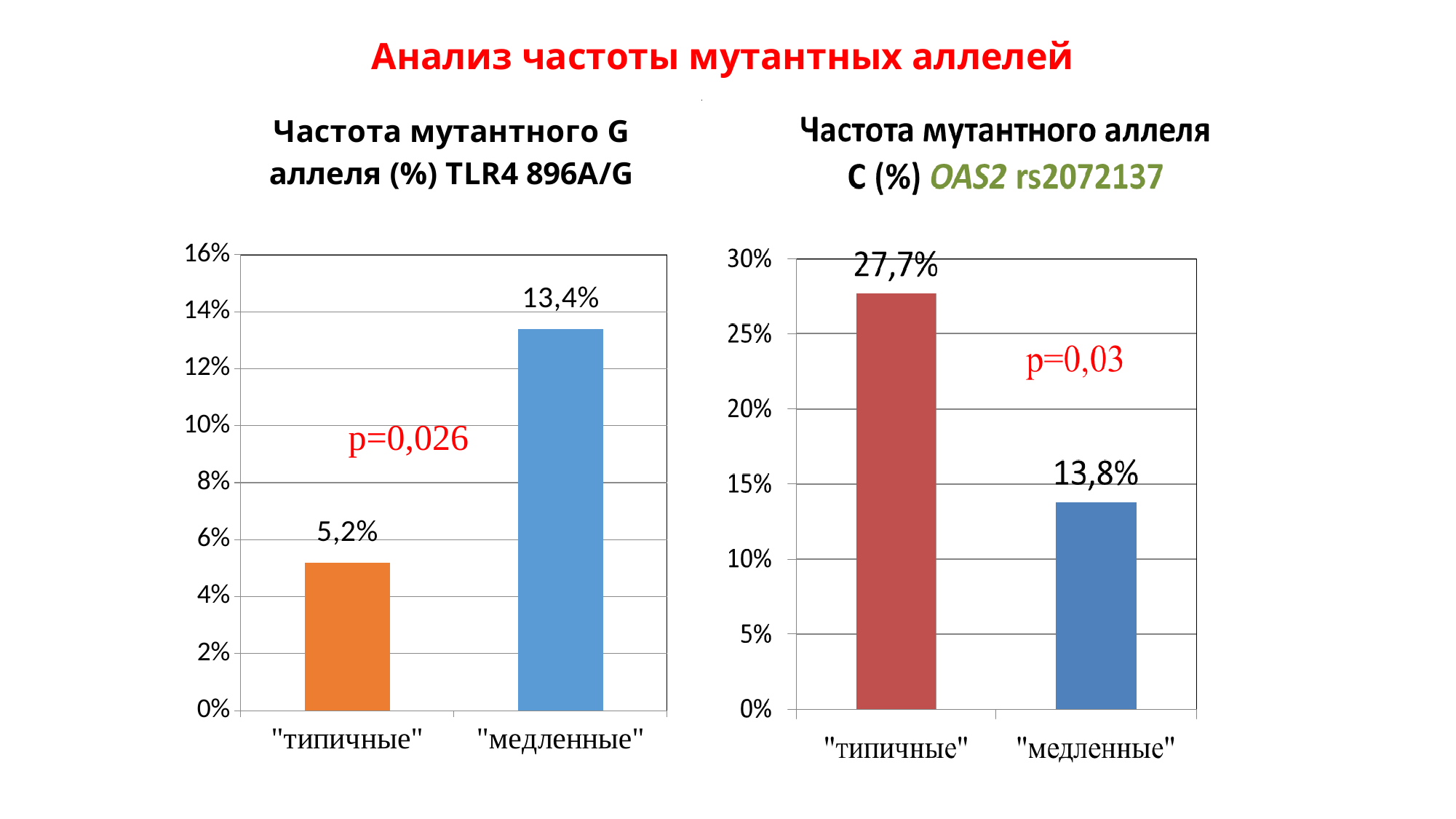
How many categories are shown in the left chart (TLR4 896A/G)? 2 What p-value is printed on the left chart (TLR4 896A/G)? p=0,026 In the right chart (OAS2 rs2072137), which is larger: the value for "типичные" or "медленные"? "типичные" In the right chart (OAS2 rs2072137), what is the value for "типичные"? 27,7% In the left chart (TLR4 896A/G), what is the value for "медленные"? 13,4% What kind of chart is the right chart (OAS2 rs2072137)? Bar chart In the right chart (OAS2 rs2072137), what is the difference between the values for "типичные" and "медленные"? 13,9% In the left chart (TLR4 896A/G), what is the value for "типичные"? 5,2% In the right chart (OAS2 rs2072137), what is the value for "медленные"? 13,8% In the left chart (TLR4 896A/G), what is the difference between the values for "медленные" and "типичные"? 8,2% In the right chart (OAS2 rs2072137), which category has the lowest value? "медленные" In the left chart (TLR4 896A/G), which category has the highest value? "медленные"